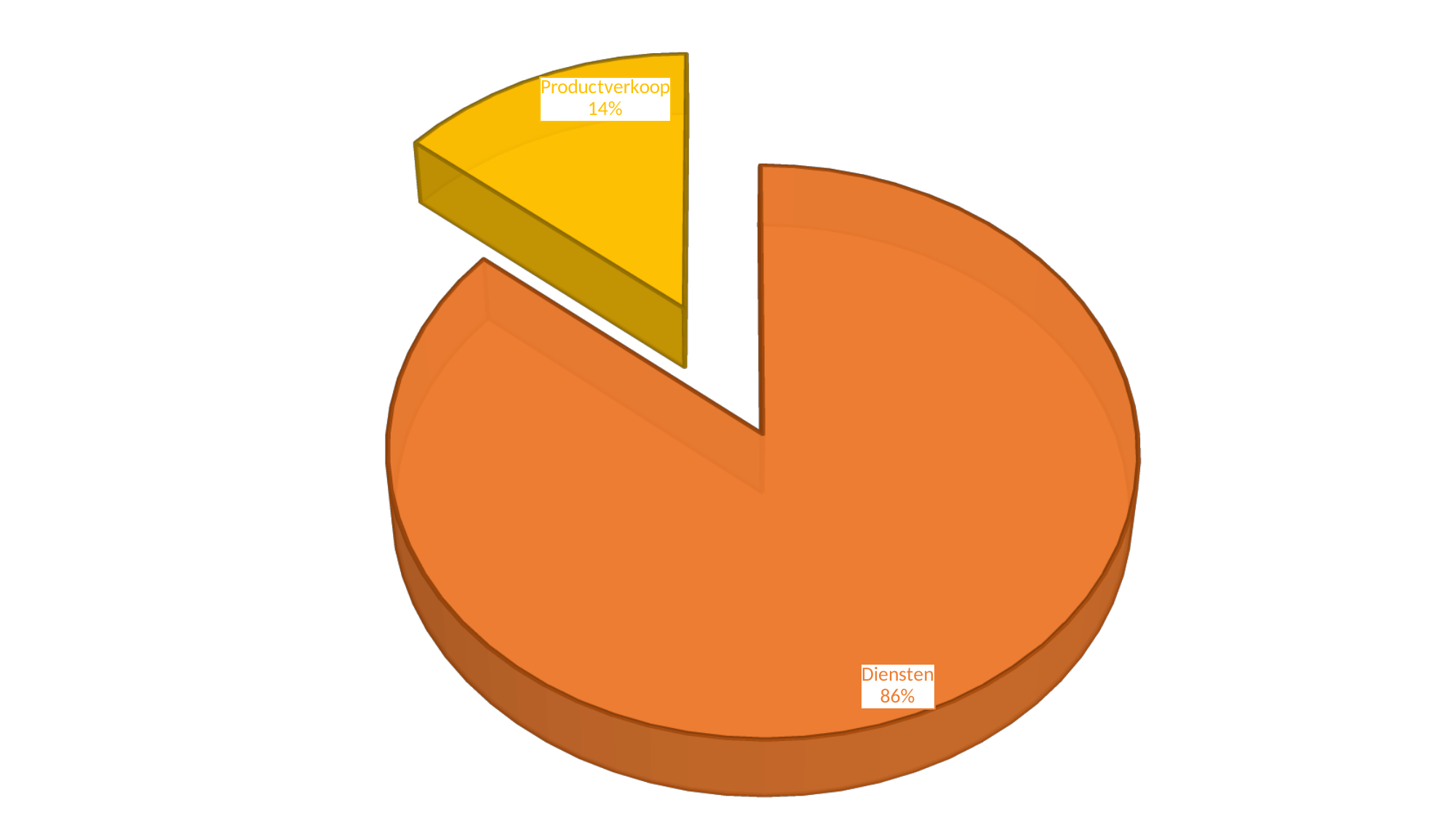
Which slice of the pie is the largest? Diensten What is the difference in percentage points between Diensten and Productverkoop? 72 What colour is the Diensten slice? orange Which slice is pulled out (exploded) from the pie? Productverkoop Which is larger, Diensten or Productverkoop? Diensten Is the share for Diensten greater or less than 50%? greater What share of the pie does Diensten represent? 86% What kind of chart is shown on the slide? pie chart Which slice of the pie is the smallest? Productverkoop What share of the pie does Productverkoop represent? 14% How many slices does the pie chart have? 2